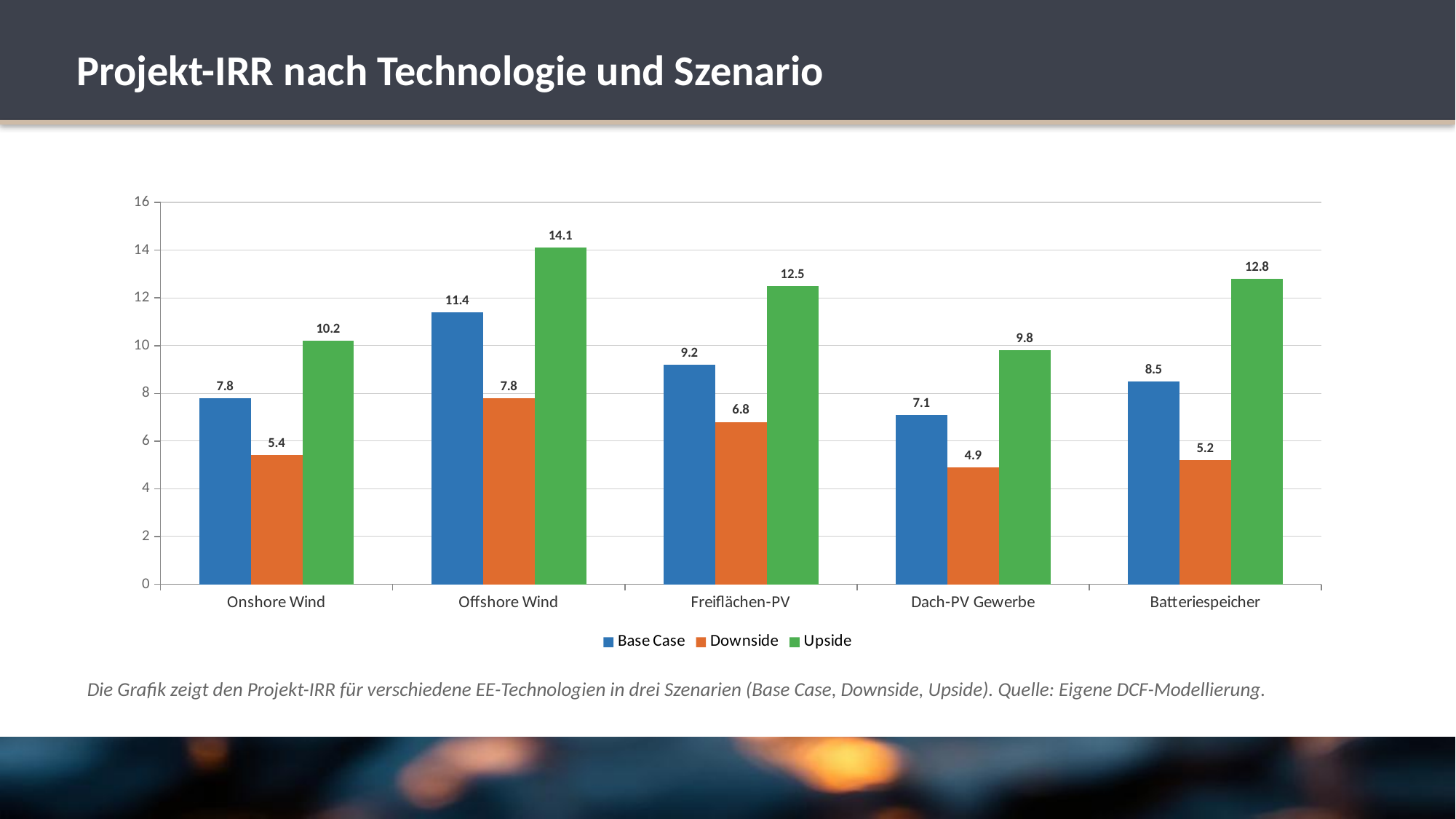
What is the Base Case value for Offshore Wind? 11.4 What kind of chart is shown on the slide? Bar chart How many categories are shown on the x axis? 5 How many series does the legend list? 3 What is the Upside value for Batteriespeicher? 12.8 What is the difference between the Upside and Downside values for Freiflächen-PV? 5.7 What is the Downside value for Dach-PV Gewerbe? 4.9 Which category has the lowest Base Case value? Dach-PV Gewerbe What is the title of the slide? Projekt-IRR nach Technologie und Szenario What is the difference between the Base Case values for Offshore Wind and Onshore Wind? 3.6 Which is larger: the Base Case value for Batteriespeicher or the Base Case value for Freiflächen-PV? Freiflächen-PV Which category has the highest Upside value? Offshore Wind